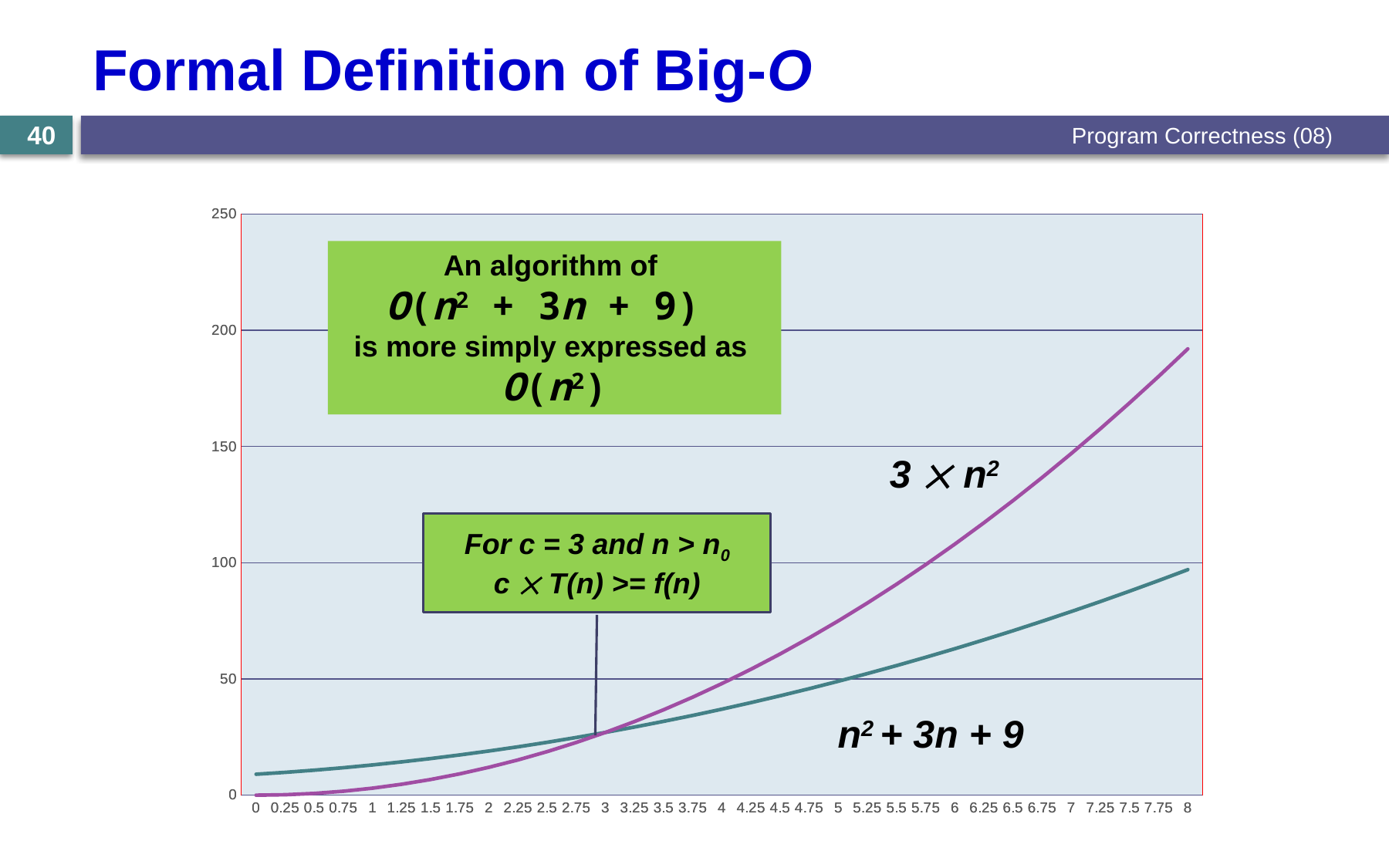
How many curves are plotted on the chart? 2 At n = 8, which curve has the higher value, 3 × n² or n² + 3n + 9? 3 × n² What kind of chart is shown on the slide? line chart At n = 1, which curve has the higher value, 3 × n² or n² + 3n + 9? n² + 3n + 9 Is the value of the n² + 3n + 9 curve at n = 0 greater or less than 50? less Do the values of the 3 × n² curve rise or fall as n increases along the x axis? rise What is the largest value shown on the x axis? 8 Is the value of the 3 × n² curve at n = 8 greater or less than 150? greater How many tick labels are shown along the x axis? 33 Is the value of the n² + 3n + 9 curve at n = 8 greater or less than 100? less What is the highest value shown on the y axis? 250